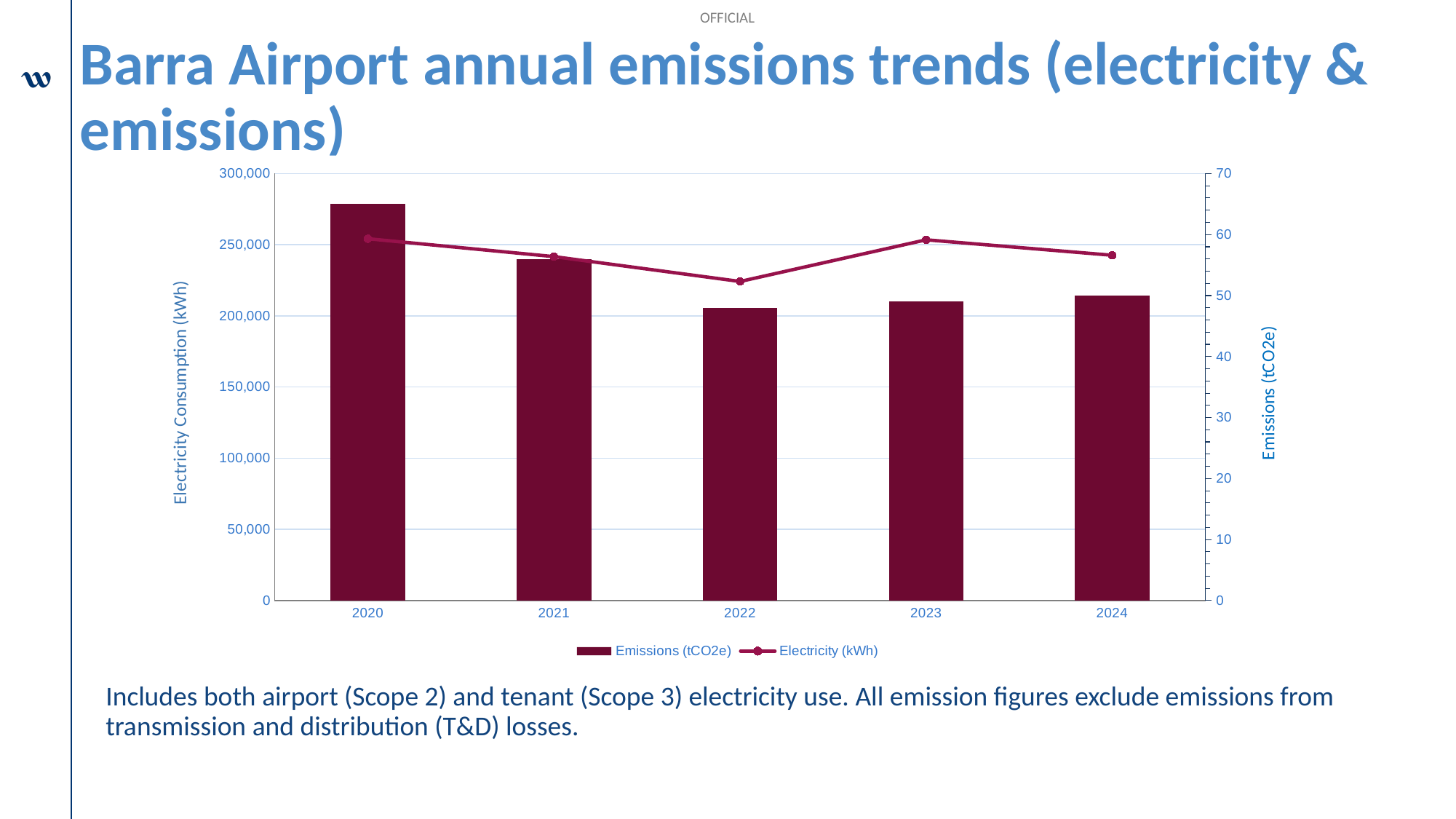
Which year has the tallest bar in the chart? 2020 What kind of chart is shown on the slide? A combined bar and line chart How many years are shown on the x axis of the chart? 5 How many series does the chart legend list? 2 Do the bars rise or fall from 2020 to 2022? fall Which year has the lowest point on the line series in the chart? 2022 Which bar is taller, 2020 or 2021? 2020 What is the title of the right-hand vertical axis of the chart? Emissions (tCO2e)